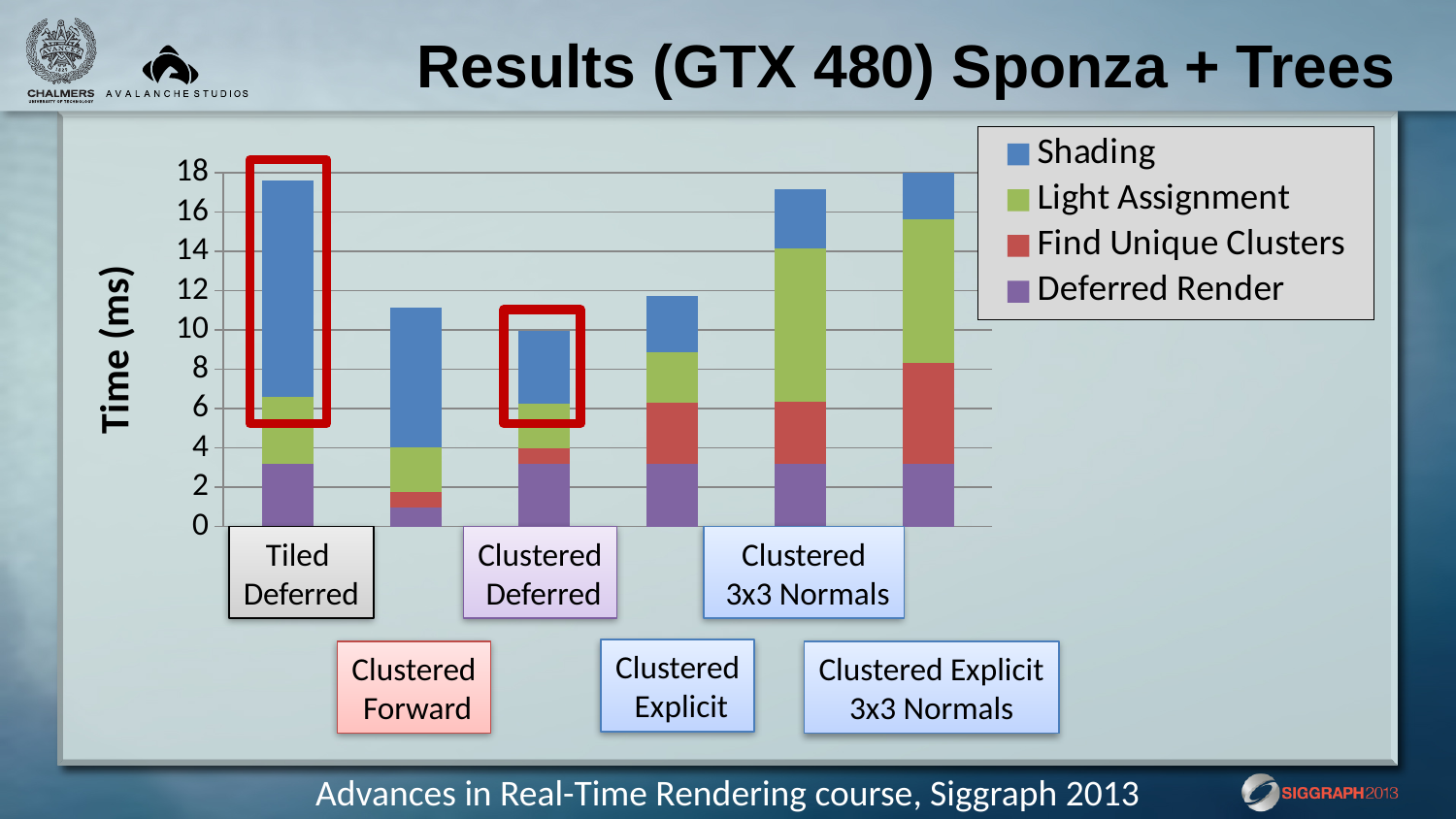
How many categories (bars) are plotted in the chart? 6 What is the label of the vertical axis? Time (ms) What kind of chart is shown on the slide? Stacked bar chart Is the total time for Clustered Deferred greater or less than 12? less How many series does the chart legend list? 4 Which has a larger total time, Clustered 3x3 Normals or Clustered Explicit? Clustered 3x3 Normals Which has a larger total time, Clustered Explicit or Clustered Deferred? Clustered Explicit Is the total time for Clustered Forward greater or less than 12? less Is the total time for Tiled Deferred greater or less than 16? greater Which has a larger total time, Tiled Deferred or Clustered Forward? Tiled Deferred Which series is drawn at the bottom of each stacked bar? Deferred Render